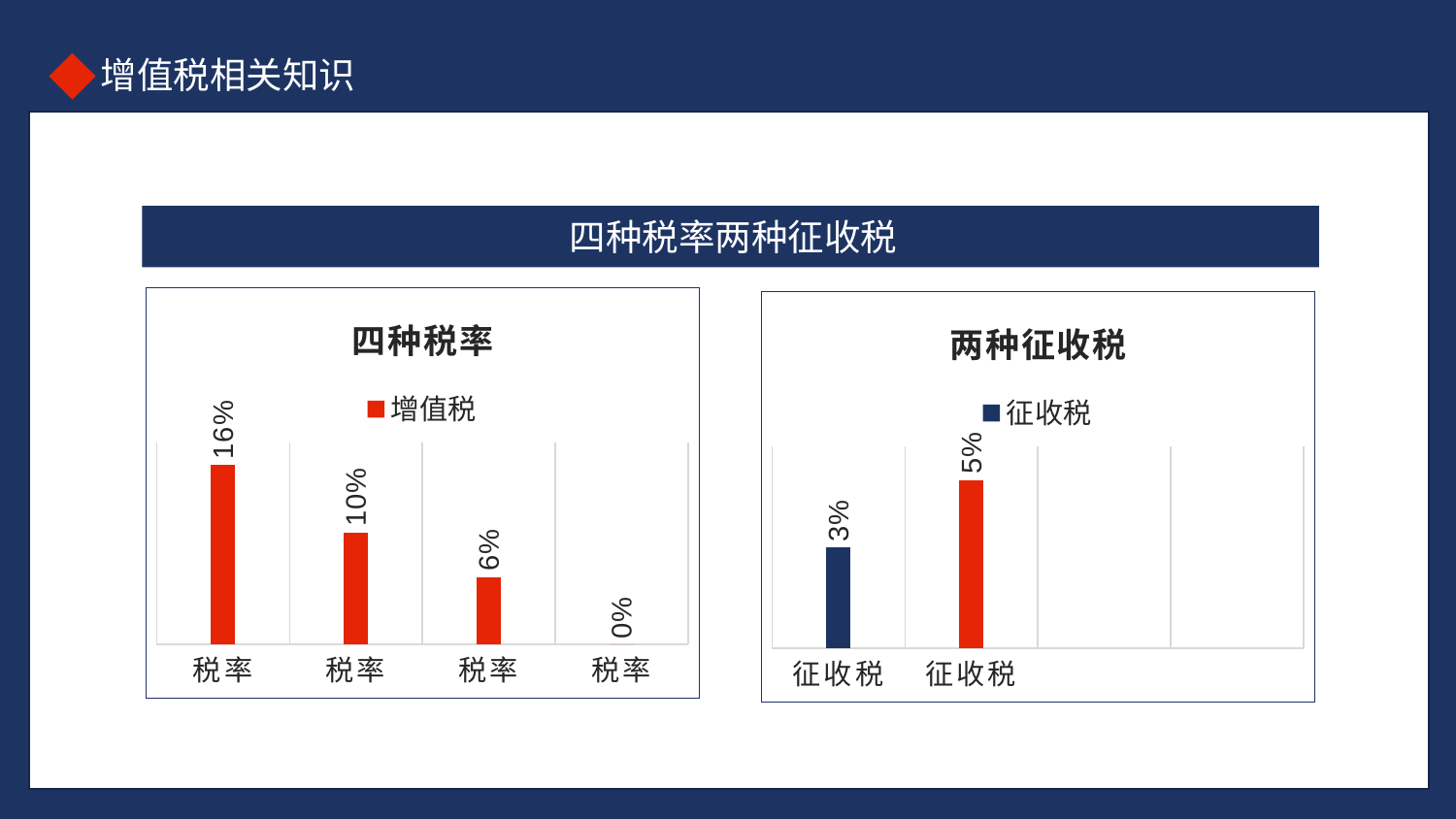
In the chart titled 四种税率, what is the value of the rightmost bar? 0% In the chart titled 四种税率, how many bars are plotted? 4 In the chart titled 四种税率, what is the difference between the first bar (16%) and the second bar (10%)? 6% In the chart titled 四种税率, do the values rise or fall from left to right? fall In the chart titled 四种税率, what series name does the legend show? 增值税 In the chart titled 两种征收税, what is the value of the first (leftmost) bar? 3% In the chart titled 两种征收税, which bar is larger, the first or the second? the second (5%) What type of chart is the chart titled 两种征收税? bar chart In the chart titled 四种税率, what is the highest value shown? 16% In the chart titled 四种税率, what is the value of the third bar from the left? 6% In the chart titled 四种税率, what is the value of the first (leftmost) bar? 16% In the chart titled 两种征收税, what is the difference between the two bars? 2%